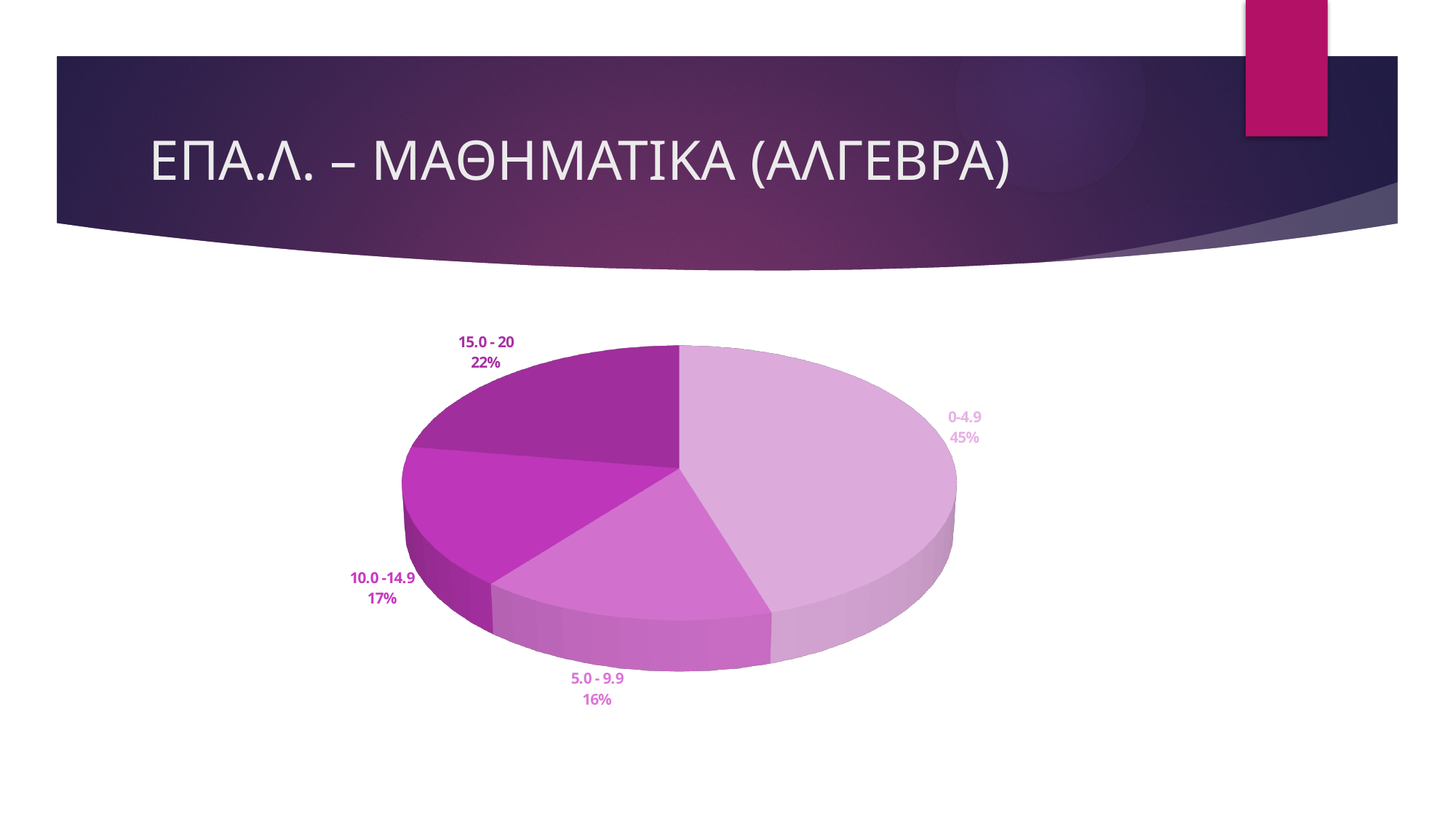
What is the difference in percentage points between the 0-4.9 slice and the 15.0 - 20 slice? 23 What share of the pie does the 10.0 -14.9 slice represent? 17% What is the combined share of the 10.0 -14.9 and 15.0 - 20 slices? 39% What share of the pie does the 15.0 - 20 slice represent? 22% What is the title of the slide containing the chart? ΕΠΑ.Λ. – ΜΑΘΗΜΑΤΙΚΑ (ΑΛΓΕΒΡΑ) What share of the pie does the 5.0 - 9.9 slice represent? 16% What kind of chart is shown on the slide? pie chart How many slices does the pie chart have? 4 Which slice is the smallest? 5.0 - 9.9 Which is larger, the 15.0 - 20 slice or the 10.0 -14.9 slice? 15.0 - 20 Which slice is the largest? 0-4.9